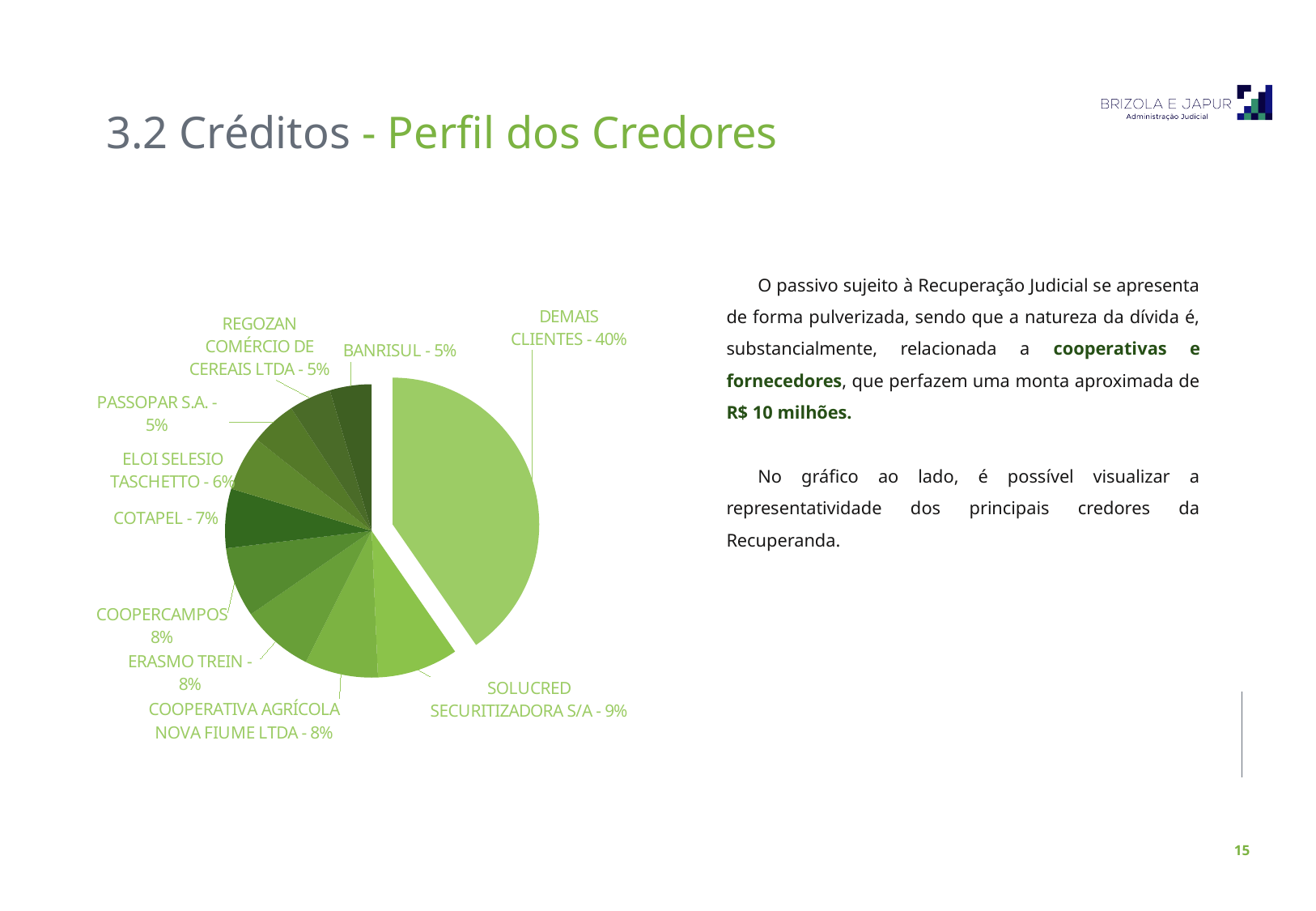
What is the difference between the shares of DEMAIS CLIENTES and SOLUCRED SECURITIZADORA S/A? 31% What is the value shown for ELOI SELESIO TASCHETTO? 6% Which is larger, the share of COTAPEL or the share of PASSOPAR S.A.? COTAPEL Which slice is pulled out (exploded) from the rest of the pie? DEMAIS CLIENTES What is the value shown for COOPERATIVA AGRÍCOLA NOVA FIUME LTDA? 8% How many slices does the pie chart have? 10 What kind of chart is shown on the slide? pie chart What is the value shown for COTAPEL? 7% What share of the pie does DEMAIS CLIENTES represent? 40% What is the difference between the shares of COOPERCAMPOS and BANRISUL? 3% What is the value shown for SOLUCRED SECURITIZADORA S/A? 9% Which category has the largest slice of the pie? DEMAIS CLIENTES